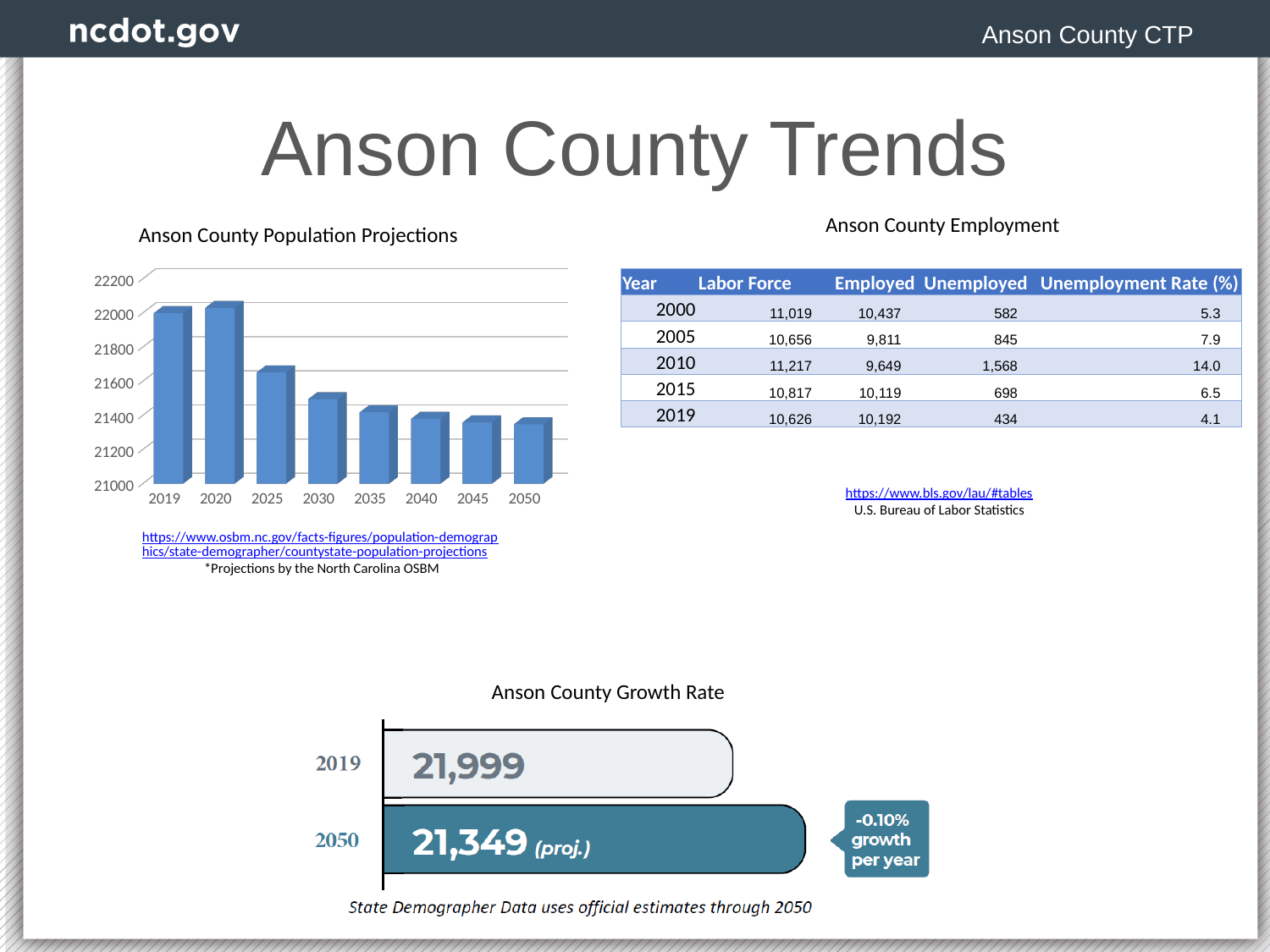
In the Anson County Population Projections chart, which year has the highest projected population? 2020 In the Anson County Population Projections chart, do the values generally rise or fall from 2020 to 2050? fall In the Anson County Population Projections chart, is the value for 2025 greater or less than 21600? greater In the Anson County Growth Rate chart, what is the value shown for 2019? 21,999 In the Anson County Growth Rate chart, what is the projected value shown for 2050? 21,349 In the Anson County Growth Rate chart, what growth per year is shown? -0.10% In the Anson County Population Projections chart, is the value for 2019 greater or less than 21800? greater What kind of chart is the Anson County Population Projections chart? bar chart In the Anson County Population Projections chart, is the value for 2050 greater or less than 21400? less How many years are shown on the x axis of the Anson County Population Projections chart? 8 In the Anson County Population Projections chart, which is larger, the value for 2019 or the value for 2050? 2019